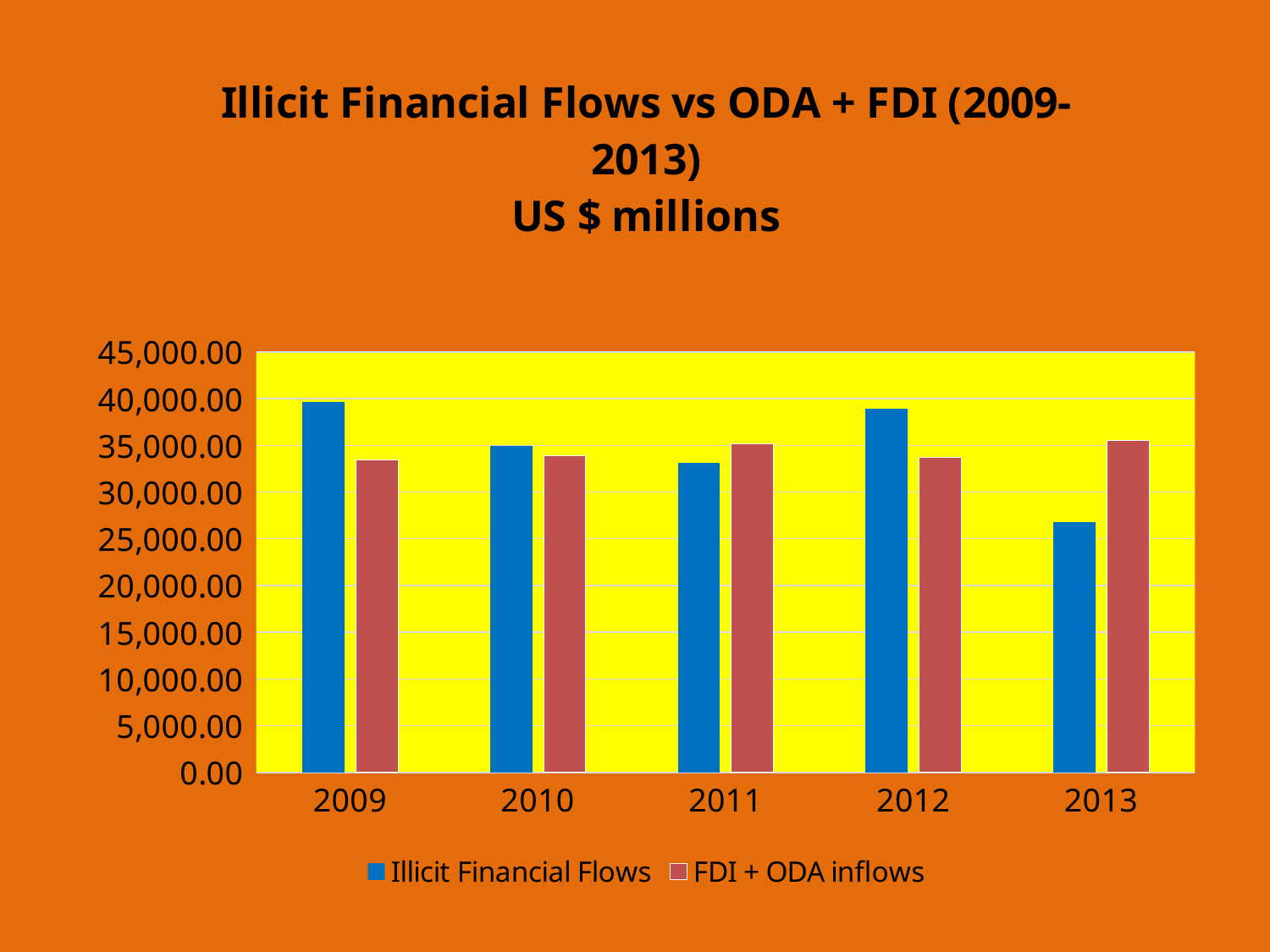
In 2013, which is larger: Illicit Financial Flows or FDI + ODA inflows? FDI + ODA inflows What unit is stated in the chart title? US $ millions In 2009, which is larger: Illicit Financial Flows or FDI + ODA inflows? Illicit Financial Flows Is the value for Illicit Financial Flows in 2011 greater or less than 35,000.00? less How many years are shown on the x axis of the chart? 5 Is the value for Illicit Financial Flows in 2012 greater or less than 35,000.00? greater What kind of chart is shown on the slide? bar chart Do Illicit Financial Flows rise or fall from 2012 to 2013? fall Which year has the lowest value for Illicit Financial Flows? 2013 How many series does the chart's legend list? 2 In 2012, which is larger: Illicit Financial Flows or FDI + ODA inflows? Illicit Financial Flows Is the value for Illicit Financial Flows in 2013 greater or less than 30,000.00? less